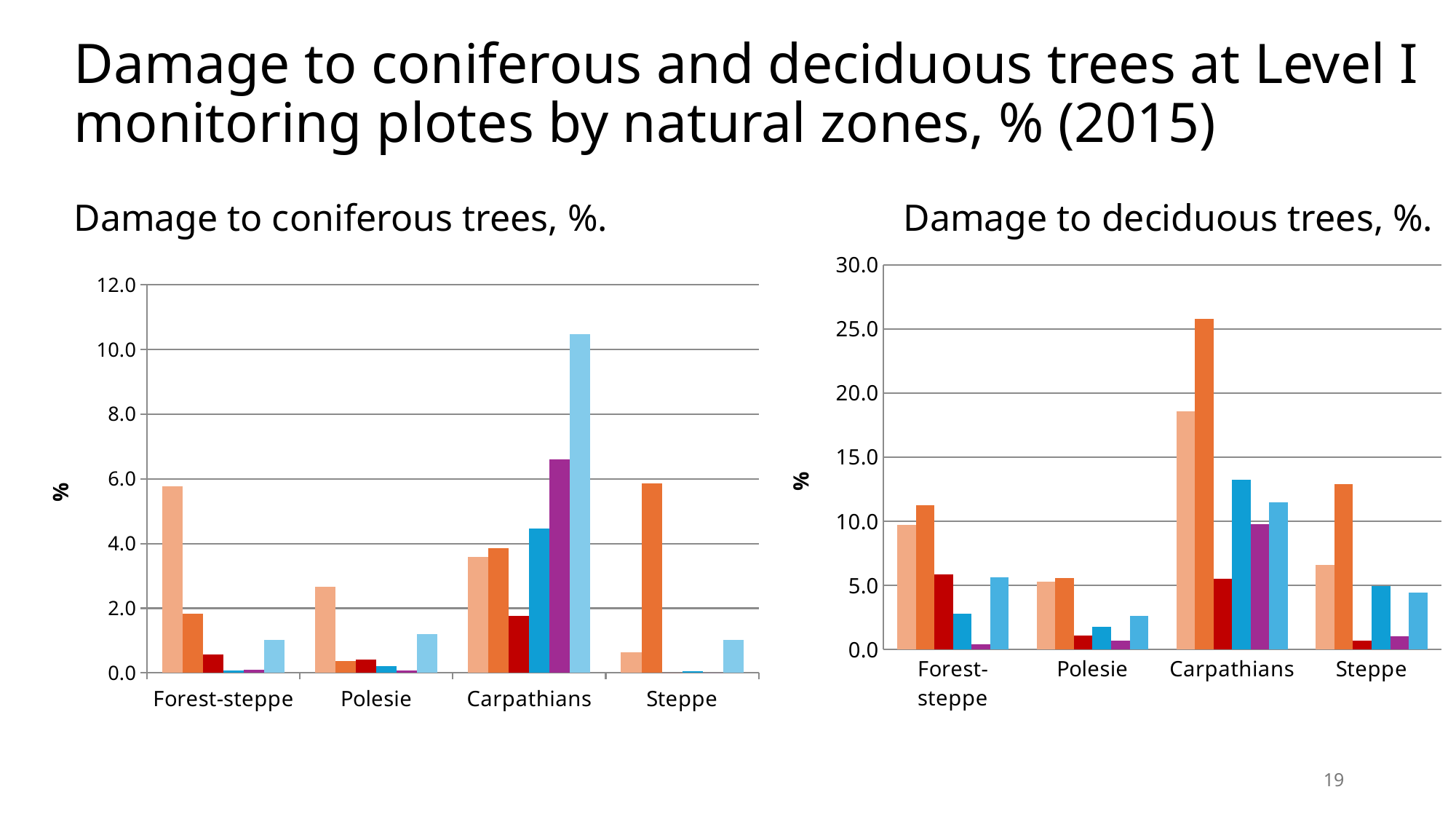
In the 'Damage to coniferous trees, %.' chart, is the light blue bar for Carpathians greater or less than 10.0? greater What is the highest value shown on the y axis of the 'Damage to deciduous trees, %.' chart? 30.0 How many natural zones are shown on the x axis of the 'Damage to deciduous trees, %.' chart? 4 In the 'Damage to deciduous trees, %.' chart, is the orange bar for Carpathians greater or less than 25.0? greater In the 'Damage to coniferous trees, %.' chart, which natural zone has the tallest bar? Carpathians In the 'Damage to deciduous trees, %.' chart, is the light orange bar for Carpathians greater or less than 20.0? less In the 'Damage to coniferous trees, %.' chart, which is taller: the light blue bar for Carpathians or the orange bar for Steppe? the light blue bar for Carpathians In the 'Damage to deciduous trees, %.' chart, which natural zone has the tallest bar? Carpathians What kind of chart is the 'Damage to coniferous trees, %.' chart? bar chart